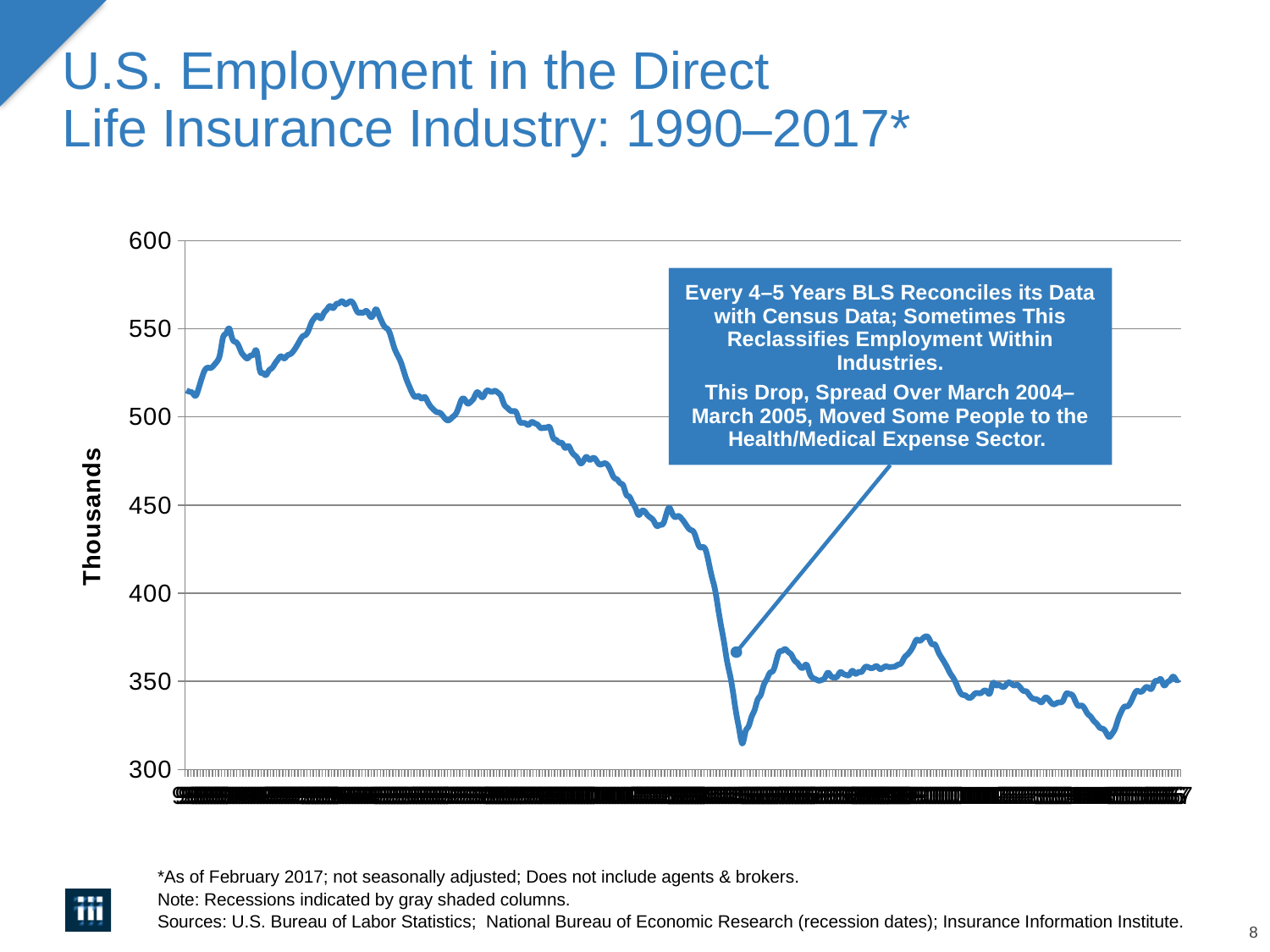
Is the value at the start of the series (1990) greater or less than 500? greater Is the lowest point of the line greater or less than 300? greater Overall, does employment in the direct life insurance industry rise or fall from 1990 to 2017 along the x axis? fall Is the lowest point of the line greater or less than 350? less How many lines (series) are plotted on the chart? 1 What kind of chart is shown on the slide? line chart What is the title of the vertical axis? Thousands According to the annotation, over which period was the sharp drop spread? March 2004–March 2005 Which is larger, the value at the start of the series in 1990 or the value at the end of the series in 2017? 1990